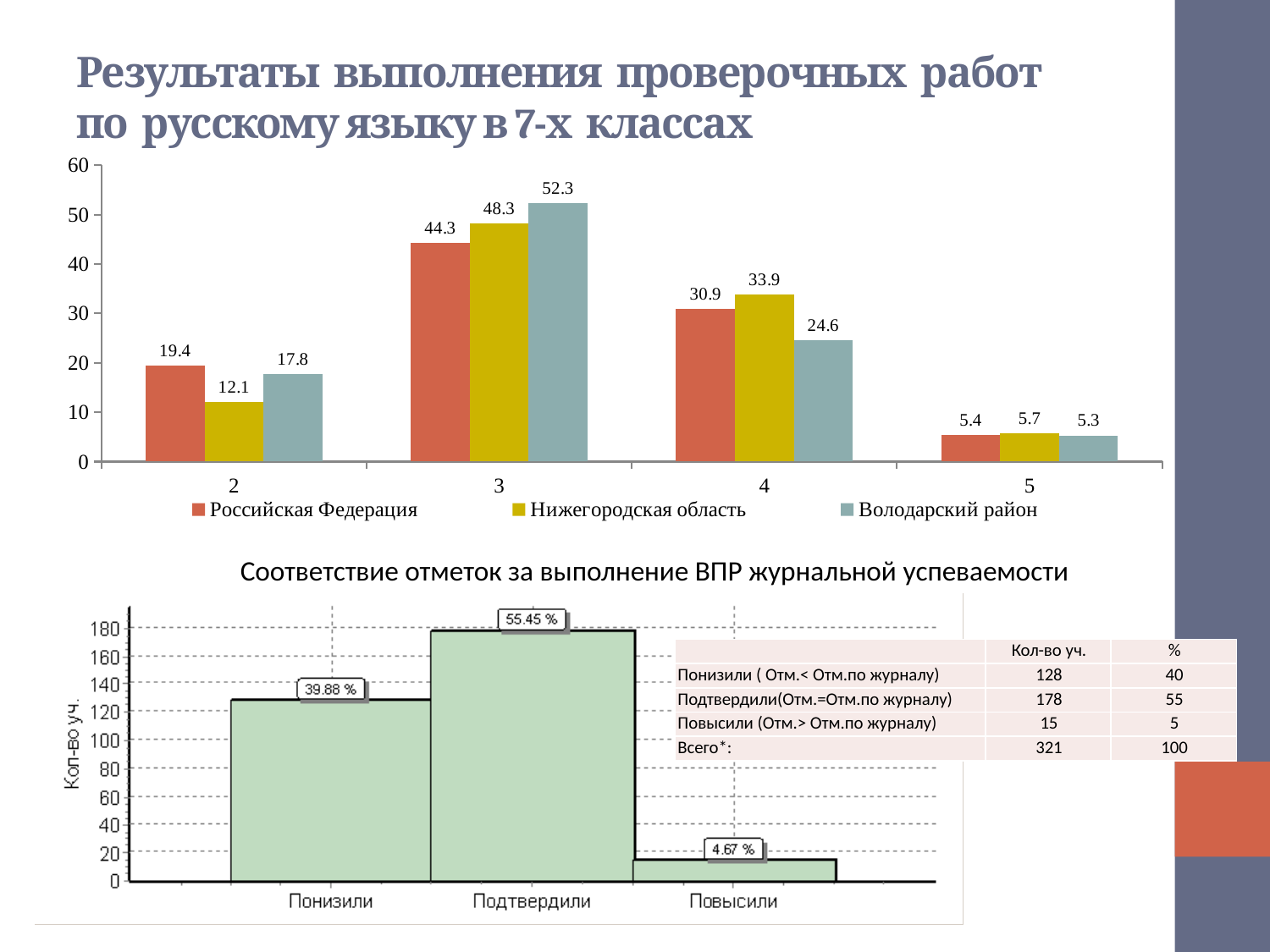
In the top chart, what is the value for Нижегородская область for category 2? 12.1 In the top chart, which is larger for category 4: Нижегородская область or Володарский район? Нижегородская область In the top chart, which category has the highest value for Володарский район? 3 How many series does the legend of the top chart list? 3 In the bottom chart 'Соответствие отметок за выполнение ВПР журнальной успеваемости', which category has the lowest bar? Повысили What kind of chart is the bottom chart 'Соответствие отметок за выполнение ВПР журнальной успеваемости'? bar chart How many categories are shown on the x axis of the top chart? 4 In the top chart, what is the difference between Володарский район and Российская Федерация for category 3? 8 In the bottom chart 'Соответствие отметок за выполнение ВПР журнальной успеваемости', what percentage is labelled on the Подтвердили bar? 55.45 % In the top chart, which category has the lowest value for Российская Федерация? 5 In the top chart, what is the value for Российская Федерация for category 3? 44.3 In the top chart, what is the value for Володарский район for category 4? 24.6